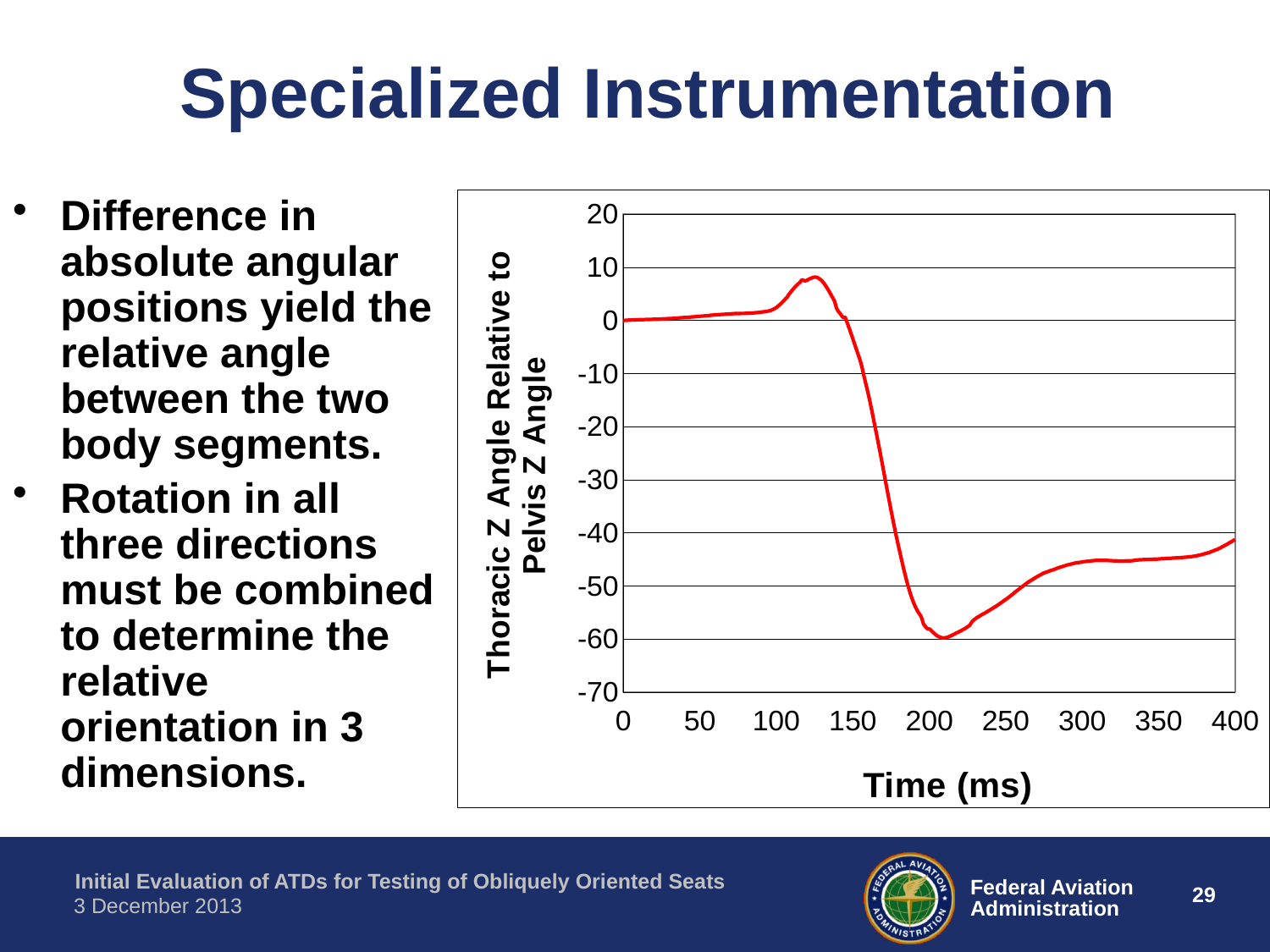
What kind of chart is shown on the slide? line chart What is the label of the y axis of the chart? Thoracic Z Angle Relative to Pelvis Z Angle Is the highest value reached by the line greater or less than 0? greater Is the value of the line at 250 ms greater or less than -40? less Is the lowest value reached by the line greater or less than -70? greater What is the label of the x axis of the chart? Time (ms) Does the line rise or fall between 150 ms and 200 ms? fall Does the line rise or fall between 250 ms and 400 ms? rise